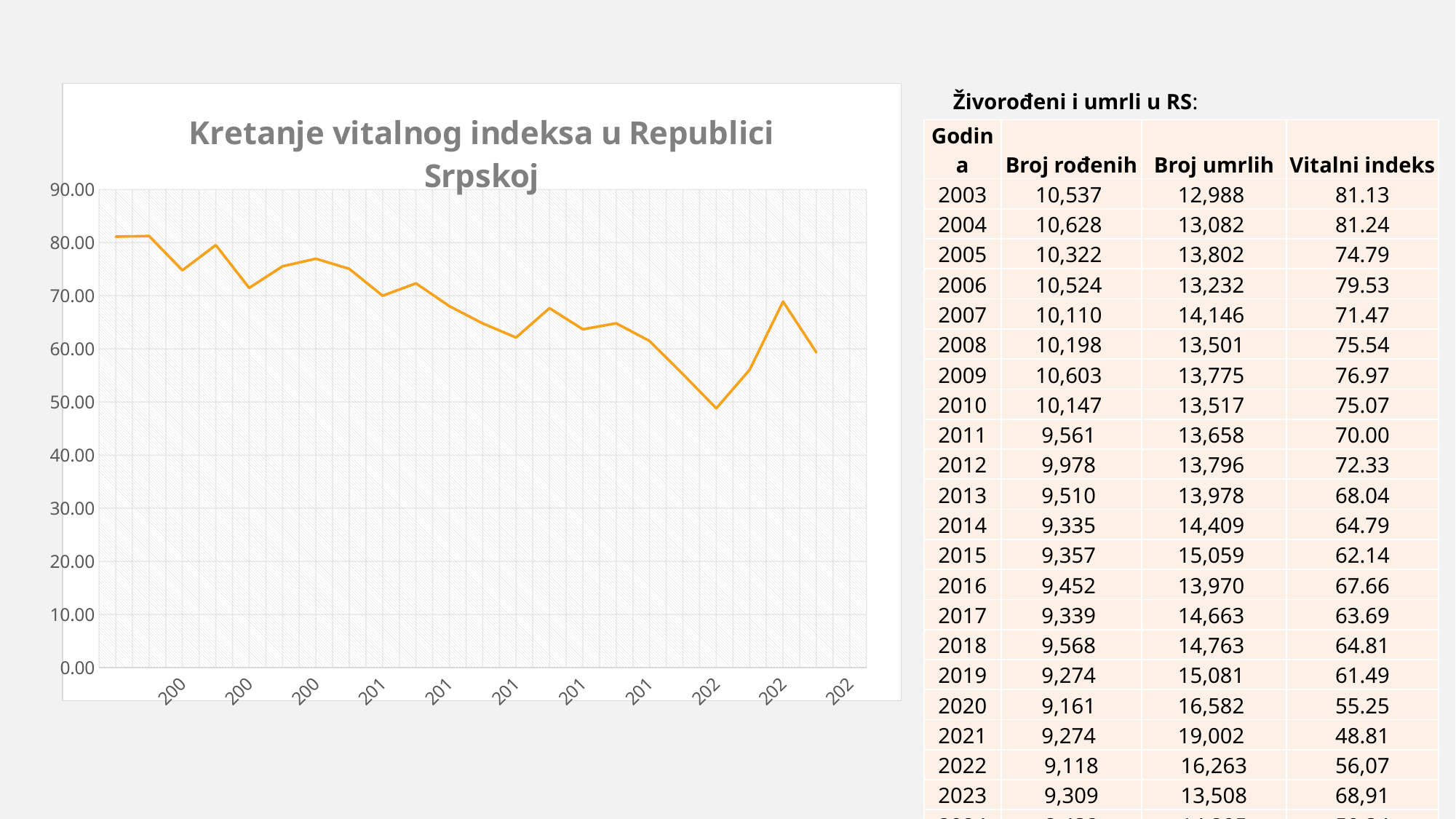
Overall, do the values in the chart rise or fall from left to right along the x axis? fall Which is larger in the chart: the first point of the line or the last point of the line? the first point Is the lowest point of the line in the chart greater or less than 40? greater Is the first point of the line in the chart greater or less than 70? greater How many data points are plotted on the line in the chart? 22 What kind of chart is shown on the slide? line chart Is the first point of the line in the chart greater or less than 90? less What is the title of the chart? Kretanje vitalnog indeksa u Republici Srpskoj What is the highest value shown on the chart's y axis? 90.00